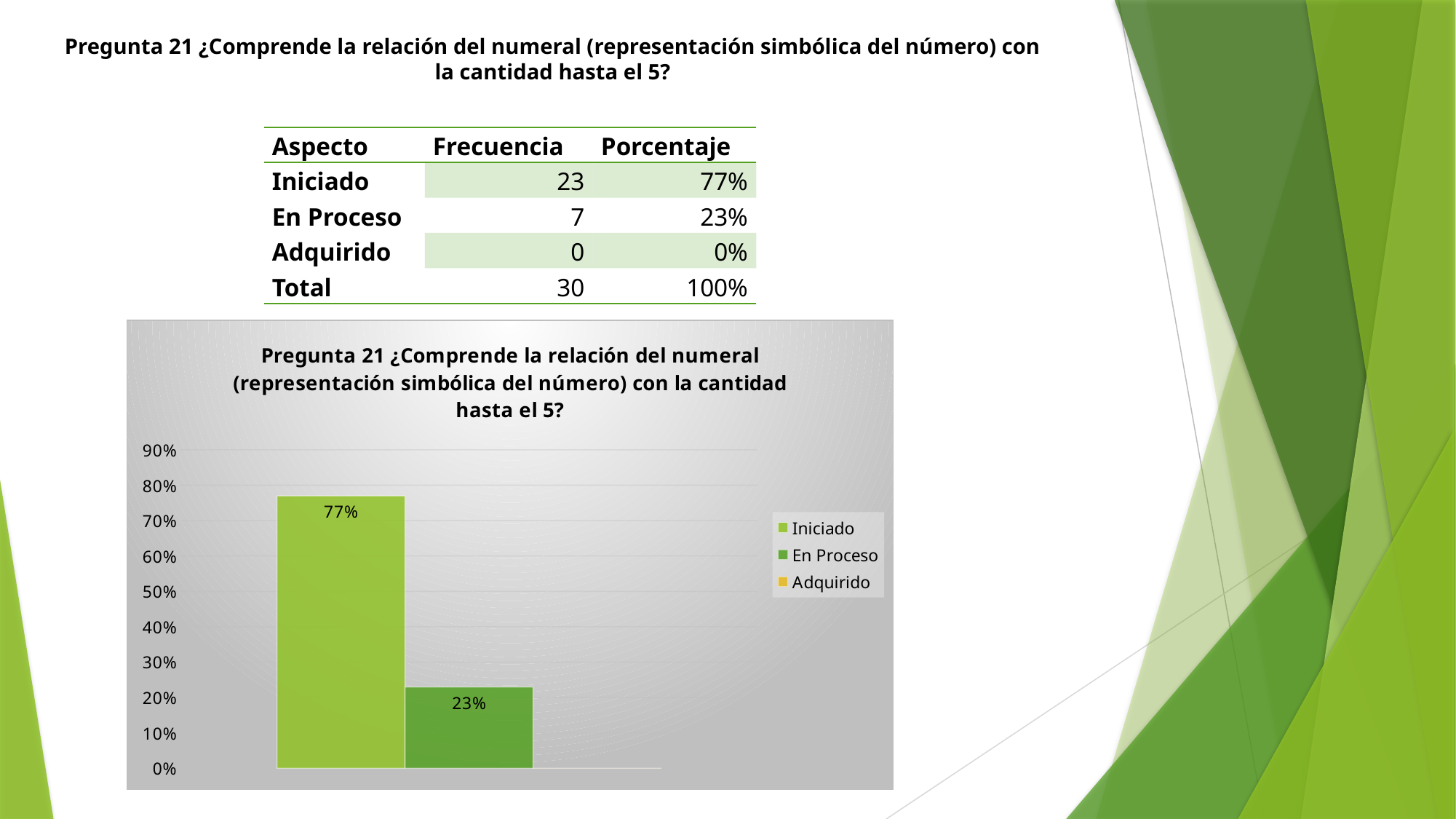
Which series has the highest value in the chart? Iniciado What is the highest value shown on the chart's vertical axis? 90% What kind of chart is shown on the slide? Bar chart Is the value for Iniciado greater or less than 70%? greater Which is larger in the chart, Iniciado or En Proceso? Iniciado How many bars are visible in the chart? 2 What is the value for Iniciado in the chart? 77% What is the difference between the Iniciado and En Proceso values in the chart? 54% Which legend entry is shown in yellow/orange in the chart? Adquirido What is the value for En Proceso in the chart? 23% Is the value for En Proceso greater or less than 30%? less How many series does the chart legend list? 3